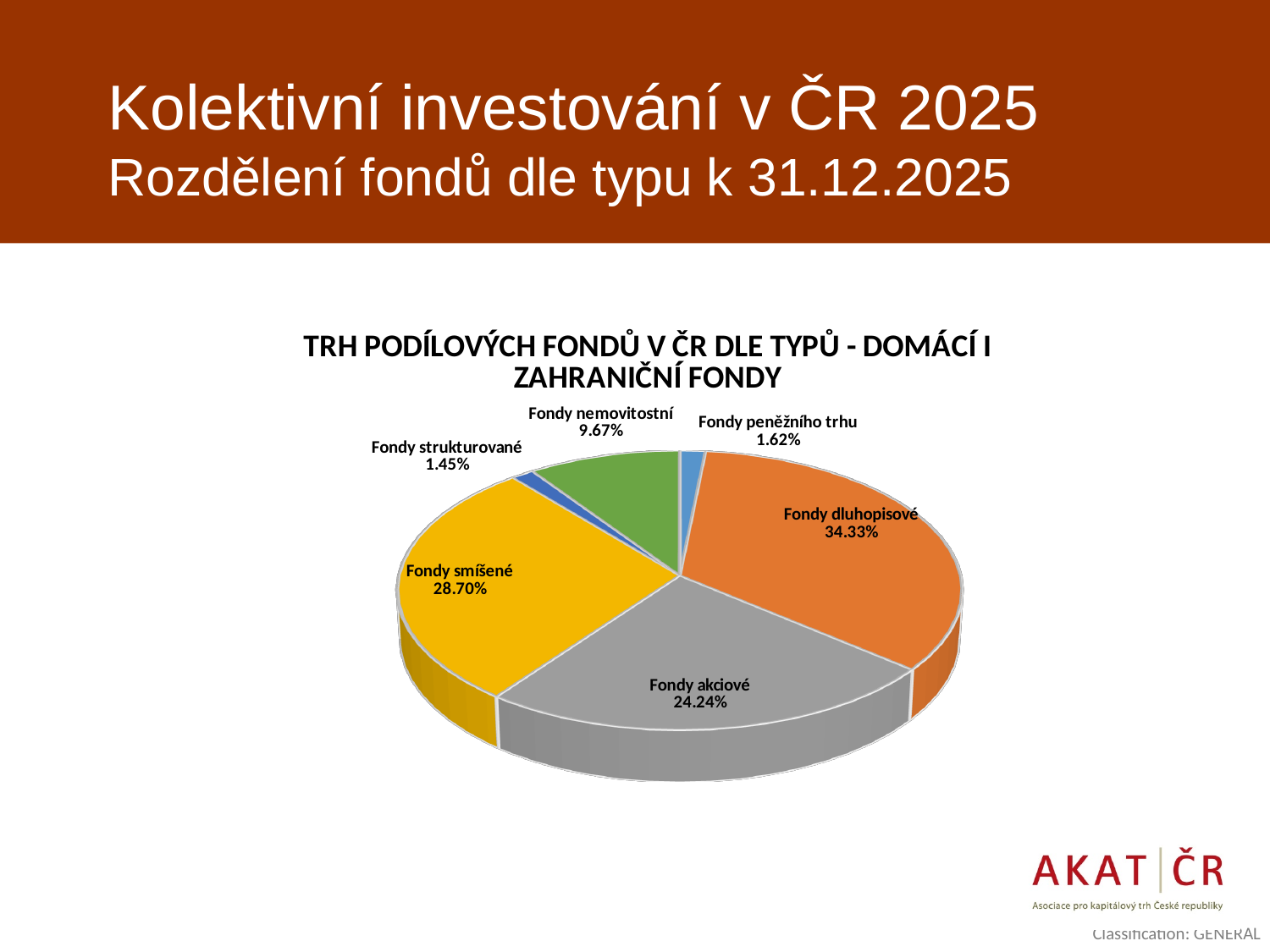
What is the value shown for Fondy nemovitostní? 9.67% What share of the pie does Fondy dluhopisové hold? 34.33% What is the value shown for Fondy akciové? 24.24% What is the value shown for Fondy peněžního trhu? 1.62% Which is larger, the share for Fondy akciové or the share for Fondy nemovitostní? Fondy akciové What colour is the slice for Fondy smíšené? Yellow Which fund type has the largest share of the pie? Fondy dluhopisové What kind of chart is shown on the slide? Pie chart How many fund types (slices) are shown in the pie chart? 6 What is the difference in percentage points between Fondy dluhopisové and Fondy smíšené? 5.63 Which fund type has the smallest share of the pie? Fondy strukturované What share of the pie does Fondy smíšené hold? 28.70%